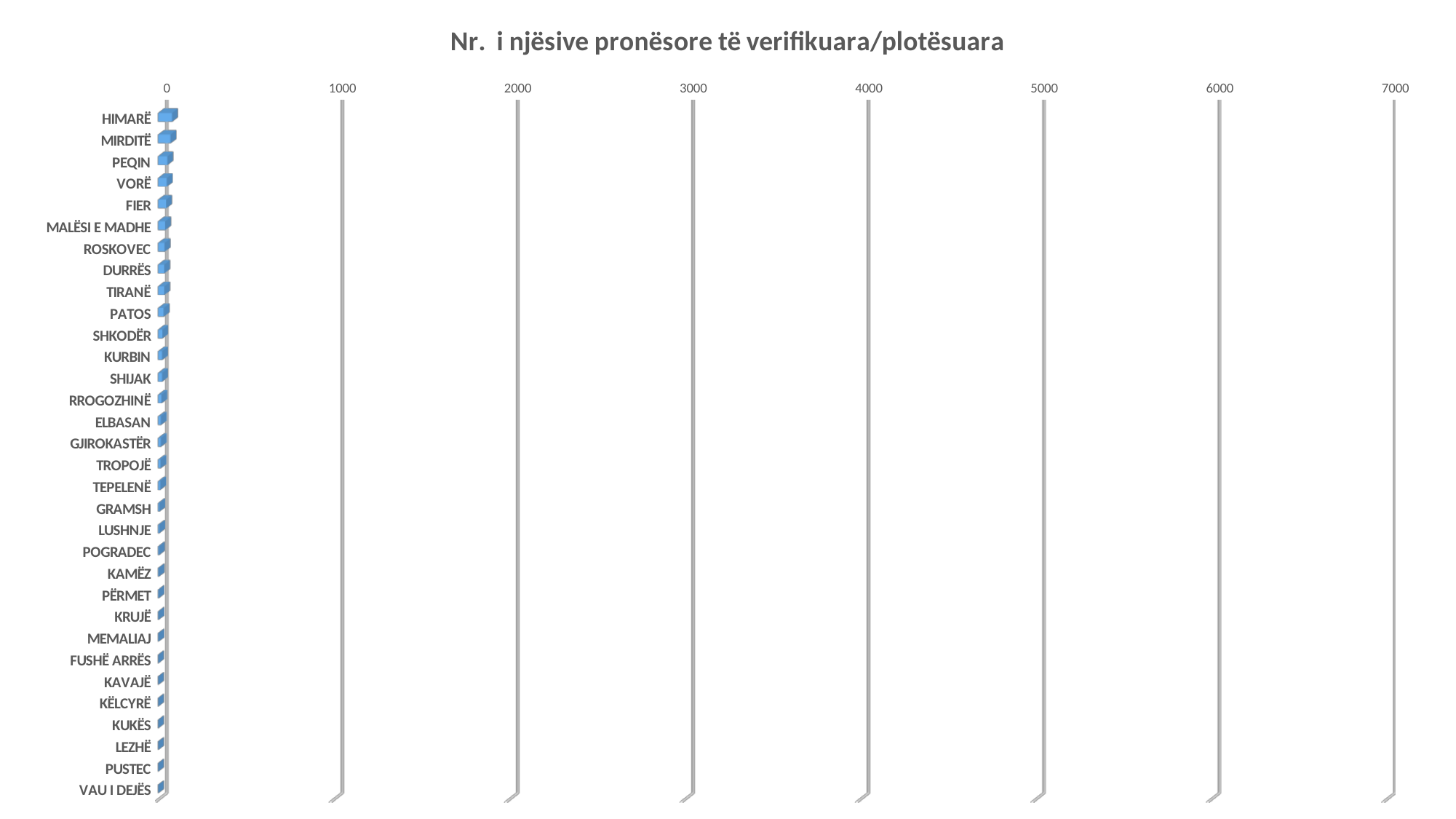
Do the bars get shorter or longer going from the top category to the bottom category? shorter Is the value for HIMARË greater or less than 1000? less What is the title of the chart? Nr. i njësive pronësore të verifikuara/plotësuara Is the value for PUSTEC greater or less than 1000? less How many categories (municipalities) are listed on the chart? 32 What is the highest value shown on the horizontal axis? 7000 Which has the larger value, HIMARË or VAU I DEJËS? HIMARË Is the value for MIRDITË greater or less than 1000? less What kind of chart is shown on the slide? bar chart Which category is listed first at the top of the chart? HIMARË Which has the larger value, MIRDITË or KUKËS? MIRDITË